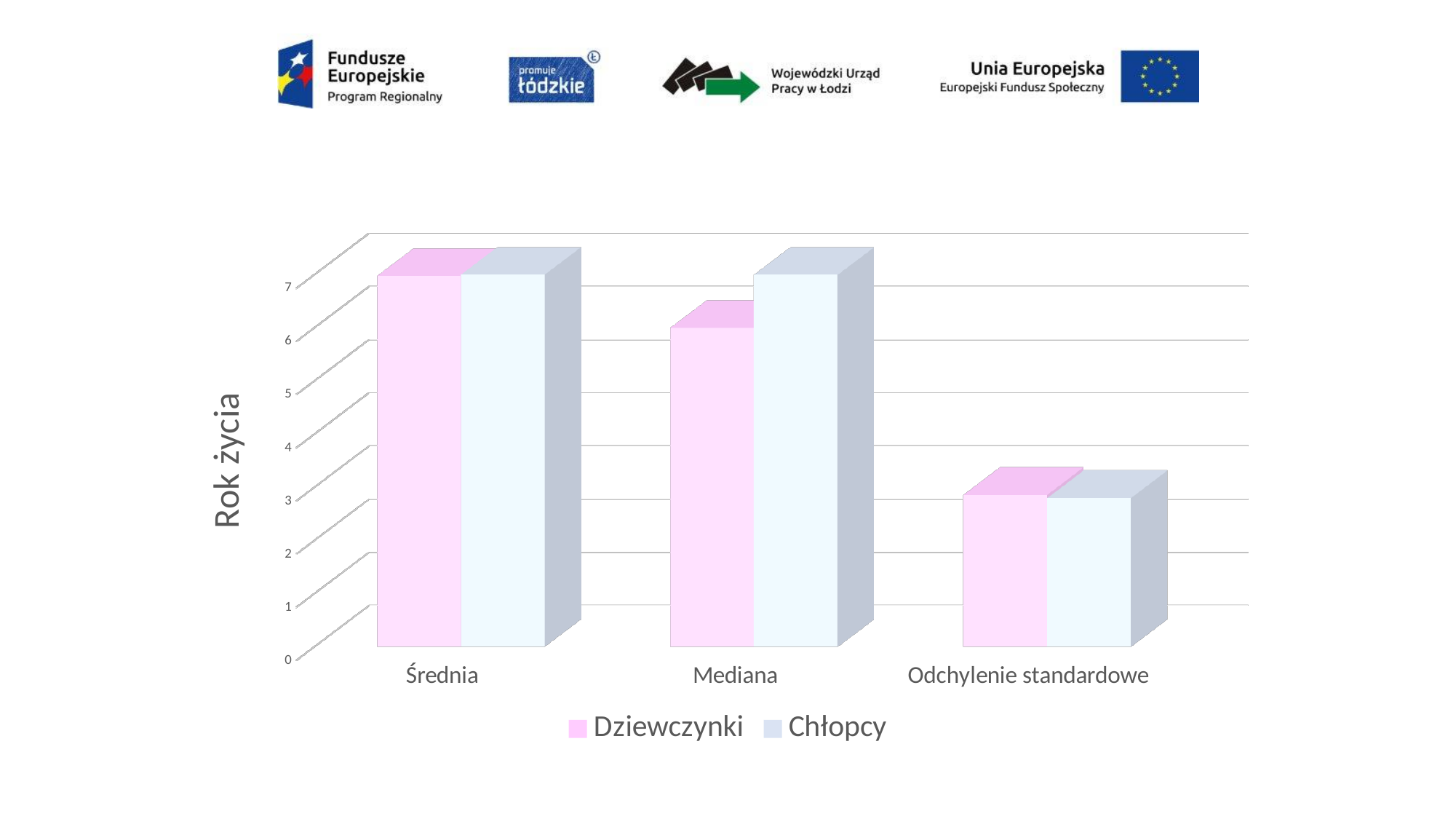
What kind of chart is shown on the slide? bar chart Which category has the highest value for the Dziewczynki series? Średnia Is the Chłopcy value for Odchylenie standardowe greater or less than 4? less What are the two series named in the chart legend? Dziewczynki and Chłopcy Which category has the lowest value for the Chłopcy series? Odchylenie standardowe Which category has the lowest value for the Dziewczynki series? Odchylenie standardowe Is the Dziewczynki value for Średnia greater or less than 6? greater What is the title of the vertical axis of the chart? Rok życia How many series does the chart legend list? 2 How many categories are shown on the x axis of the chart? 3 For the Mediana category, which series has the larger value, Dziewczynki or Chłopcy? Chłopcy Is the Dziewczynki value for Mediana greater or less than 5? greater